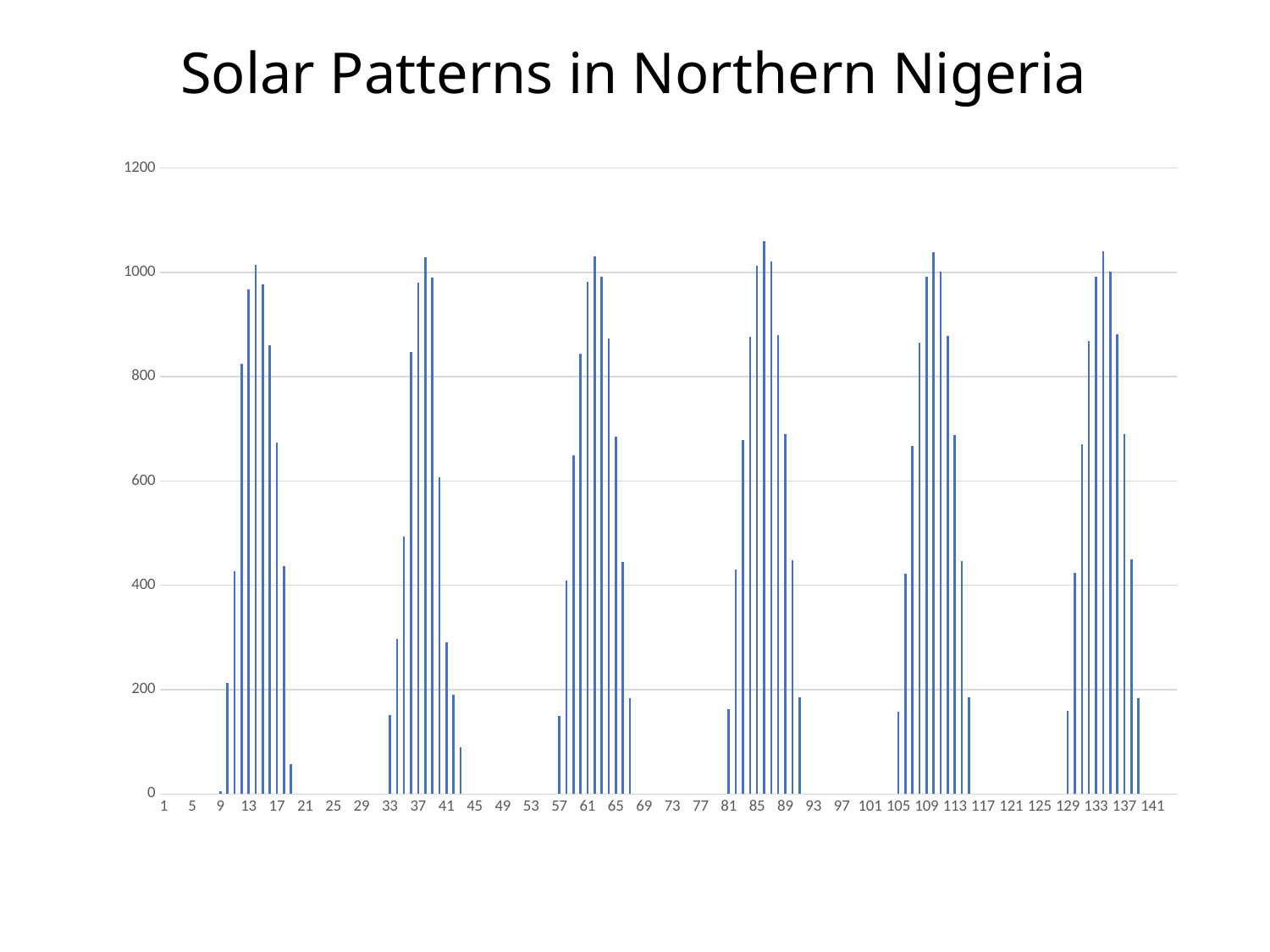
What is the highest value labelled on the vertical axis? 1200 Is the value at x = 17 greater or less than 600? greater Is the value at x = 13 greater or less than 800? greater What is the title of the chart? Solar Patterns in Northern Nigeria Are any bars plotted between x = 21 and x = 29? No Which is larger, the value at x = 12 or the value at x = 11? x = 12 Is the value at x = 86 greater or less than 1000? greater How many separate clusters of bars (peaks) appear across the x axis? 6 What kind of chart is shown on the slide? bar chart